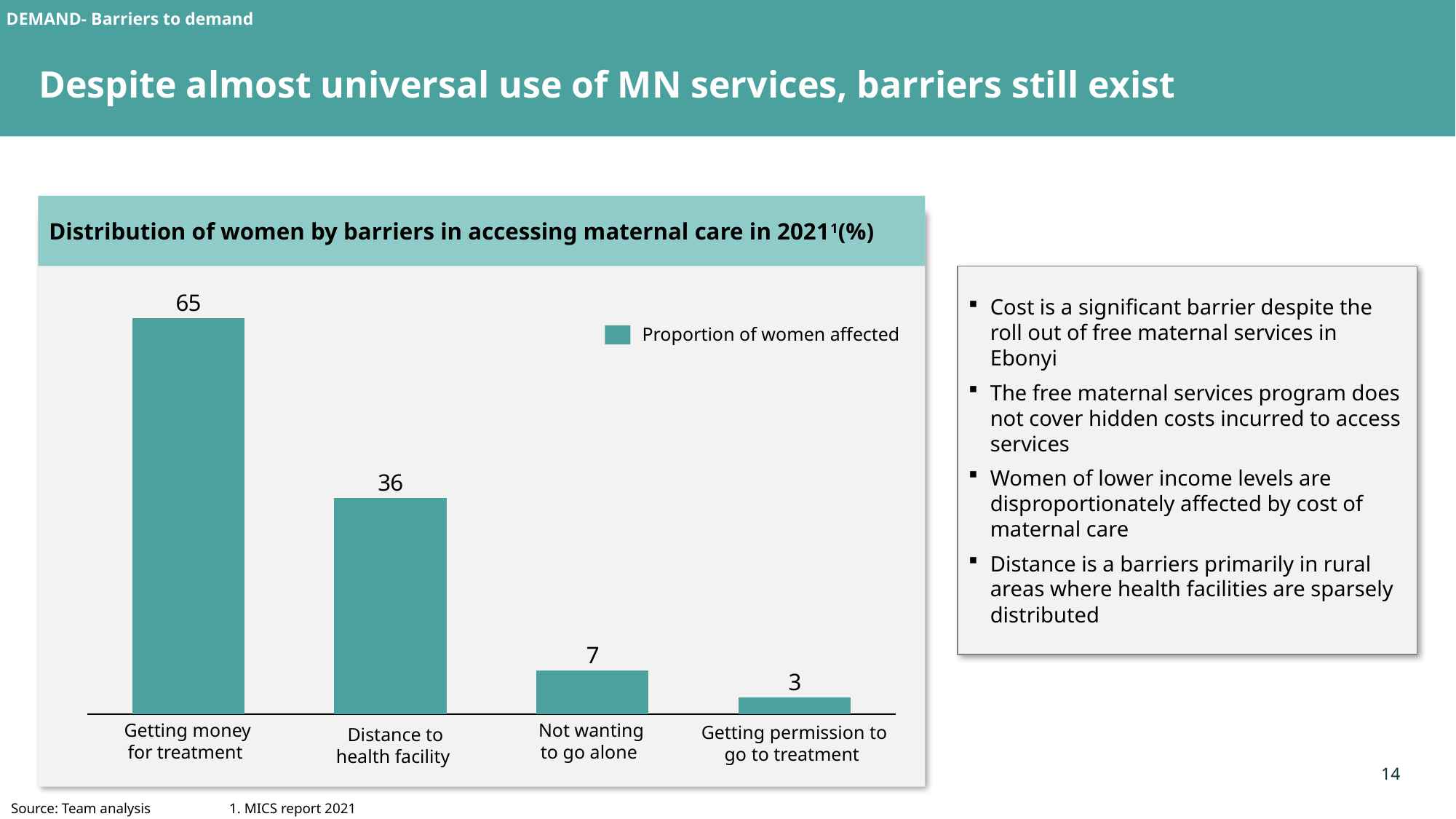
What is the value for Getting money for treatment? 65 How many series does the legend list? 1 Which barrier has the highest proportion of women affected? Getting money for treatment What is the value for Not wanting to go alone? 7 What kind of chart is shown on the slide? Bar chart What is the legend entry for the series in the chart? Proportion of women affected What is the value for Distance to health facility? 36 How many barrier categories are shown in the chart? 4 What is the value for Getting permission to go to treatment? 3 What is the difference between the values for Getting money for treatment and Distance to health facility? 29 Which barrier has the lowest proportion of women affected? Getting permission to go to treatment Which is larger, the value for Not wanting to go alone or the value for Getting permission to go to treatment? Not wanting to go alone